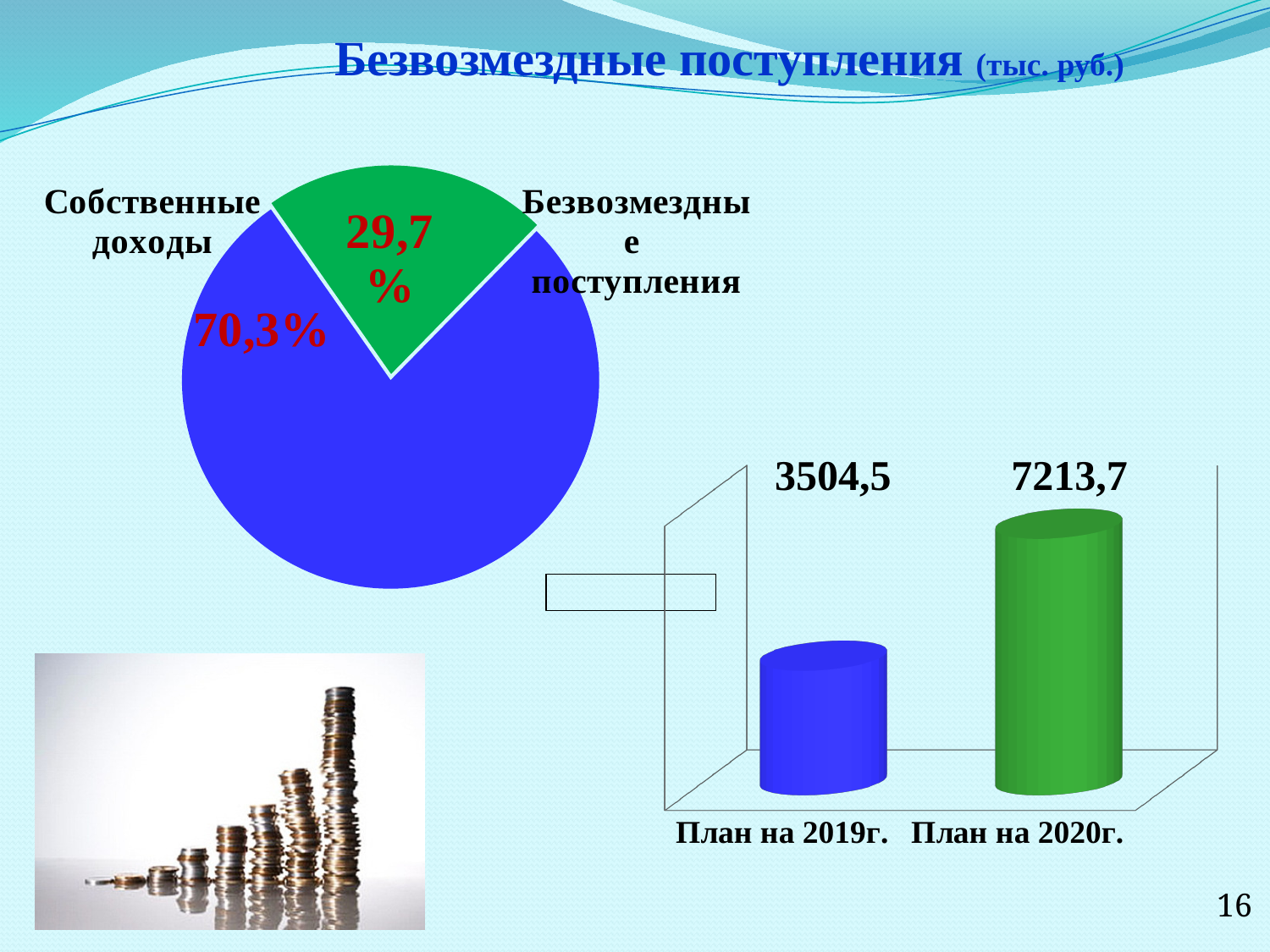
What type of chart is the chart on the left of the slide? Pie chart What type of chart is the chart at the bottom right of the slide? Bar chart How many slices does the pie chart have? 2 In the bar chart at the bottom right, what colour is the bar for План на 2020г.? Green In the bar chart at the bottom right, what is the value for План на 2020г.? 7213,7 In the bar chart at the bottom right, which category has the higher value? План на 2020г. In the pie chart, what share is labelled for Безвозмездные поступления? 29,7% In the pie chart, which slice is the largest? Собственные доходы In the bar chart at the bottom right, what is the value for План на 2019г.? 3504,5 In the pie chart, which slice is the smallest? Безвозмездные поступления In the bar chart at the bottom right, what is the difference between the values for План на 2020г. and План на 2019г.? 3709,2 In the pie chart, what share is labelled for Собственные доходы? 70,3%